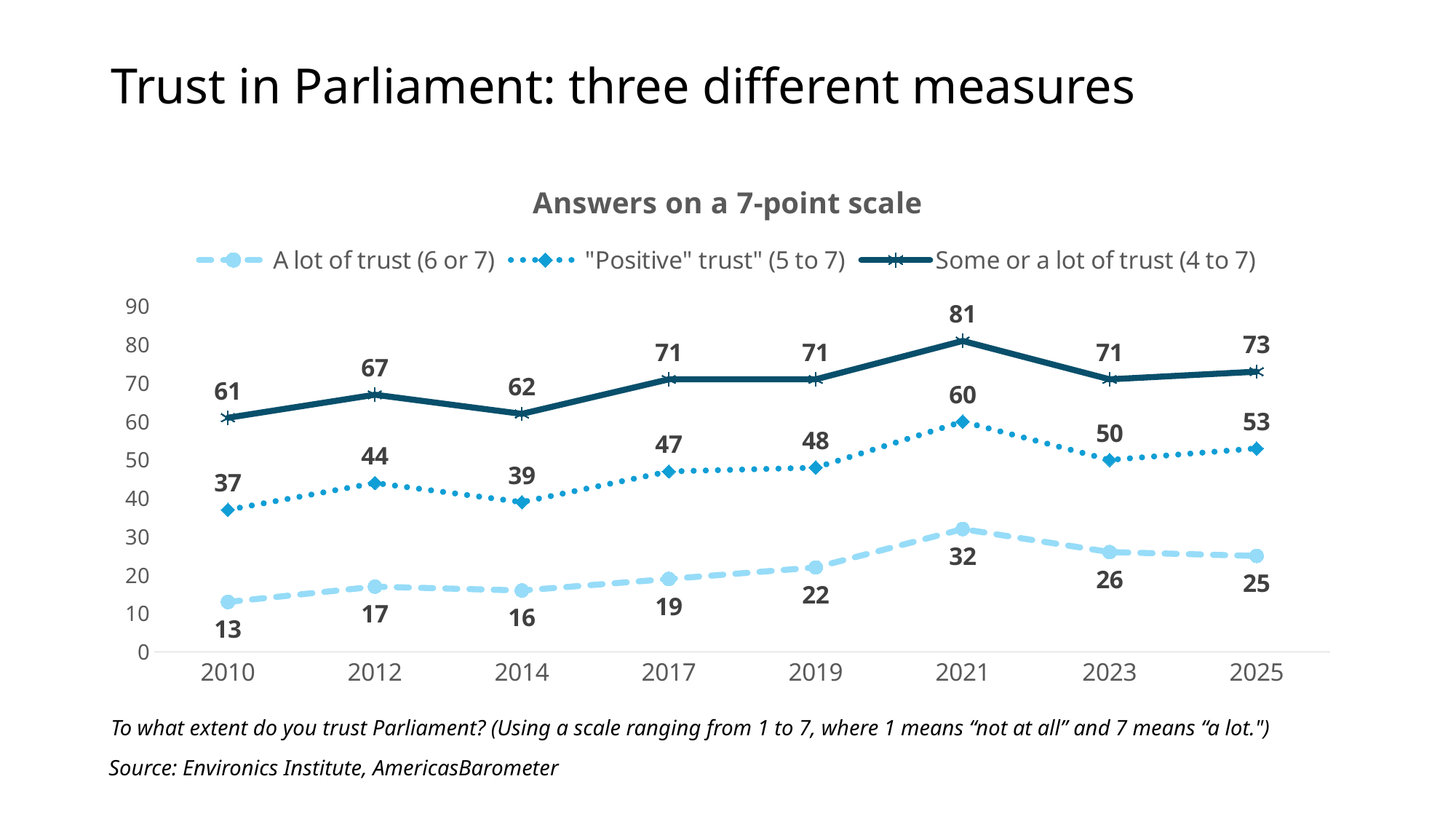
What kind of chart is shown on the slide? Line chart What is the value for "Positive" trust (5 to 7) in 2019? 48 In which year is the "Some or a lot of trust (4 to 7)" series lowest? 2010 What is the title of the chart? Answers on a 7-point scale Is the value for "Positive" trust (5 to 7) in 2021 greater or less than 50? greater How many series does the legend list? 3 In which year is the "A lot of trust (6 or 7)" series highest? 2021 What is the value for "A lot of trust (6 or 7)" in 2010? 13 Which is larger: the "Positive" trust (5 to 7) value in 2012 or in 2014? 2012 How many years are shown on the x axis? 8 What is the value for "Some or a lot of trust (4 to 7)" in 2021? 81 What is the difference between the "Some or a lot of trust (4 to 7)" value and the "A lot of trust (6 or 7)" value in 2025? 48